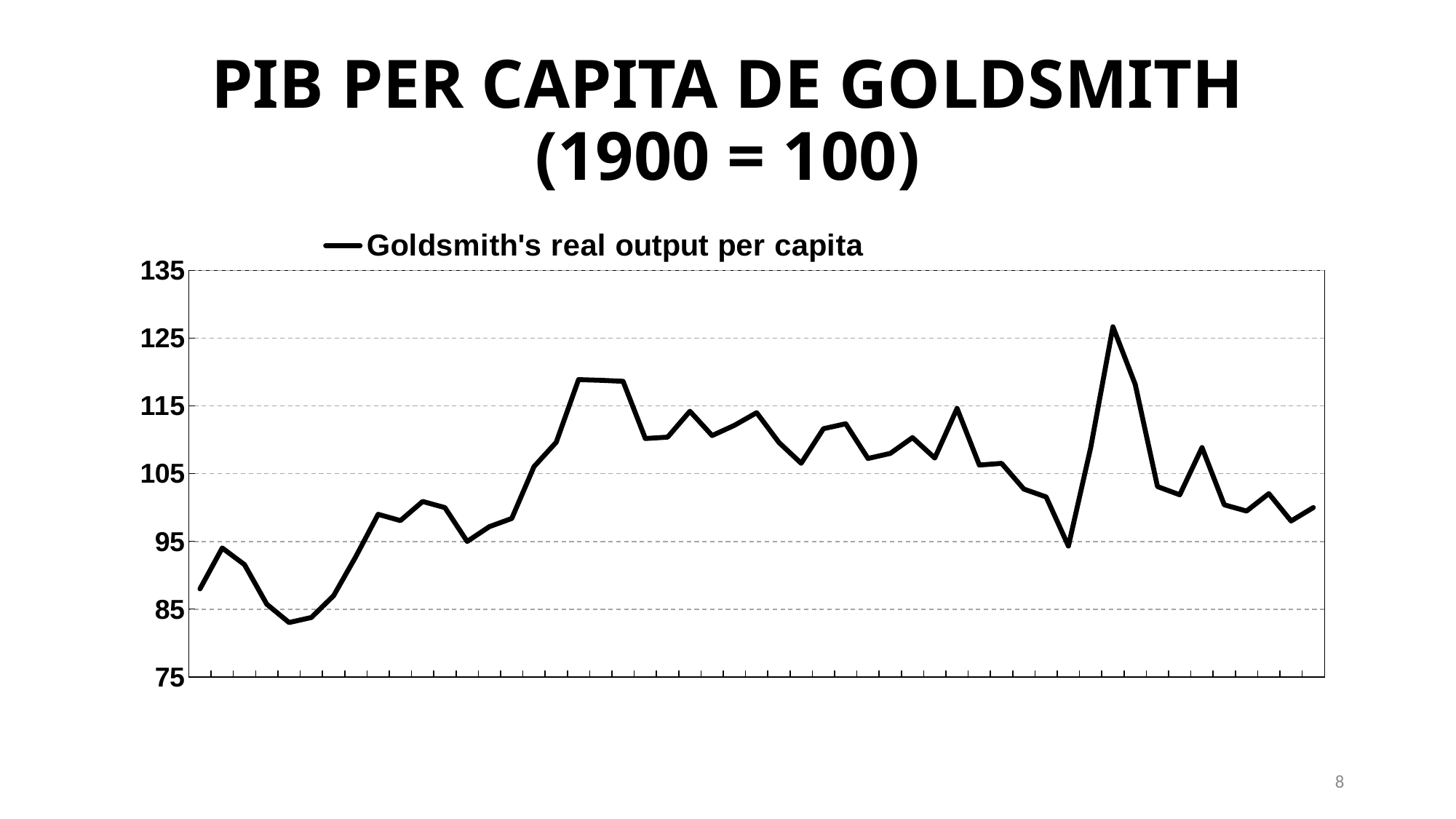
What is the title of the slide containing the chart? PIB PER CAPITA DE GOLDSMITH (1900 = 100) Does the line rise or fall between its first point and its second point? rise How many series does the legend list? 1 Is the lowest value reached by the line greater or less than 95? less Is the value at the first point of the line greater or less than 95? less What is the highest value labelled on the vertical axis? 135 Is the highest value reached by the line greater or less than 115? greater What is the name of the series shown in the legend? Goldsmith's real output per capita Is the value at the last point of the line higher or lower than the value at the first point? higher What kind of chart is shown on the slide? line chart